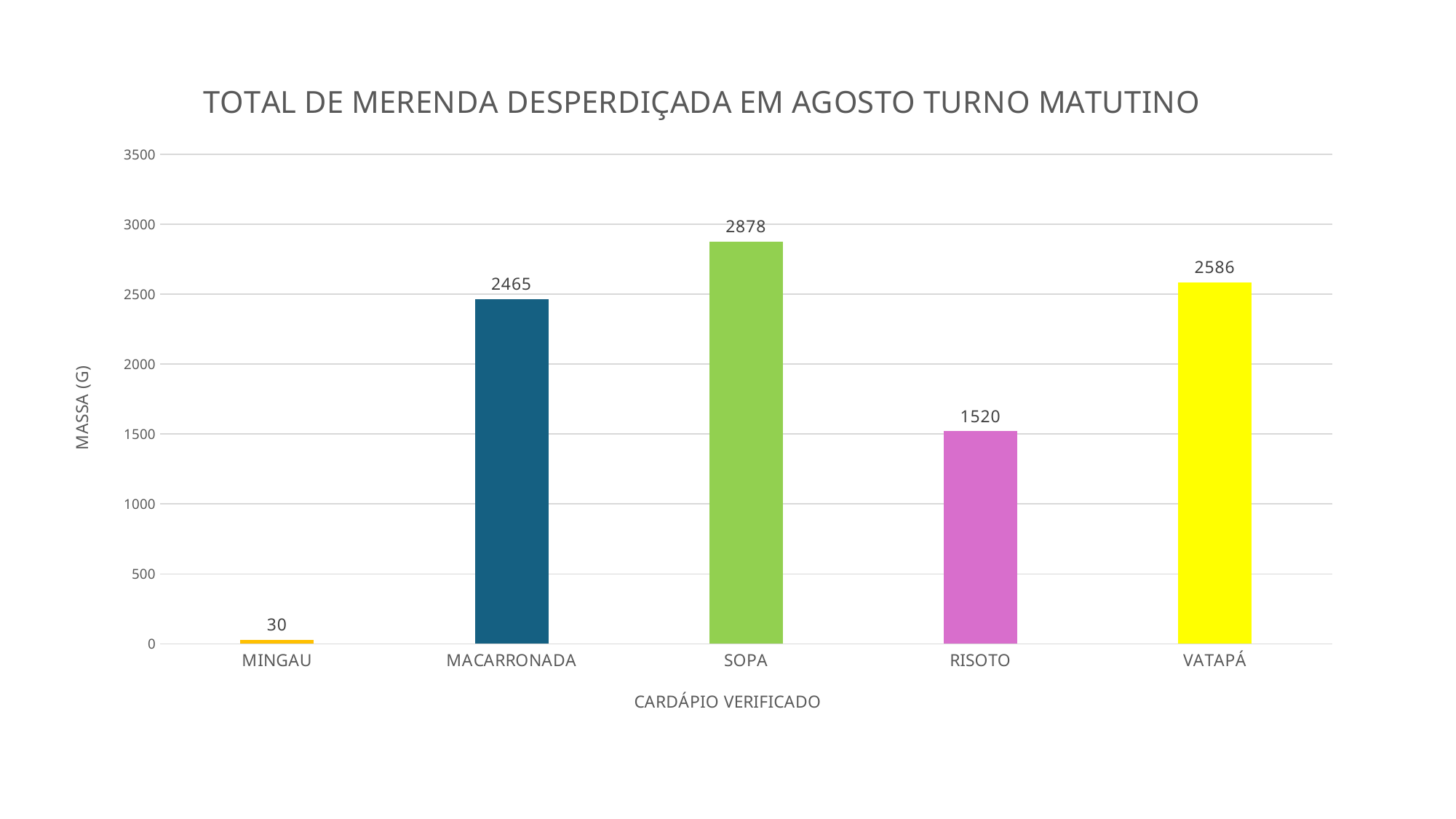
What is the difference between the values for SOPA and MACARRONADA? 413 What is the difference between the values for VATAPÁ and RISOTO? 1066 What is the value for SOPA? 2878 What is the title of the chart? TOTAL DE MERENDA DESPERDIÇADA EM AGOSTO TURNO MATUTINO How many categories are shown on the x axis? 5 Which category has the highest value? SOPA What is the value for RISOTO? 1520 Is the value for RISOTO greater or less than 2000? less What is the value for MINGAU? 30 Which is larger, the value for VATAPÁ or the value for MACARRONADA? VATAPÁ Which category has the lowest value? MINGAU What kind of chart is this? bar chart